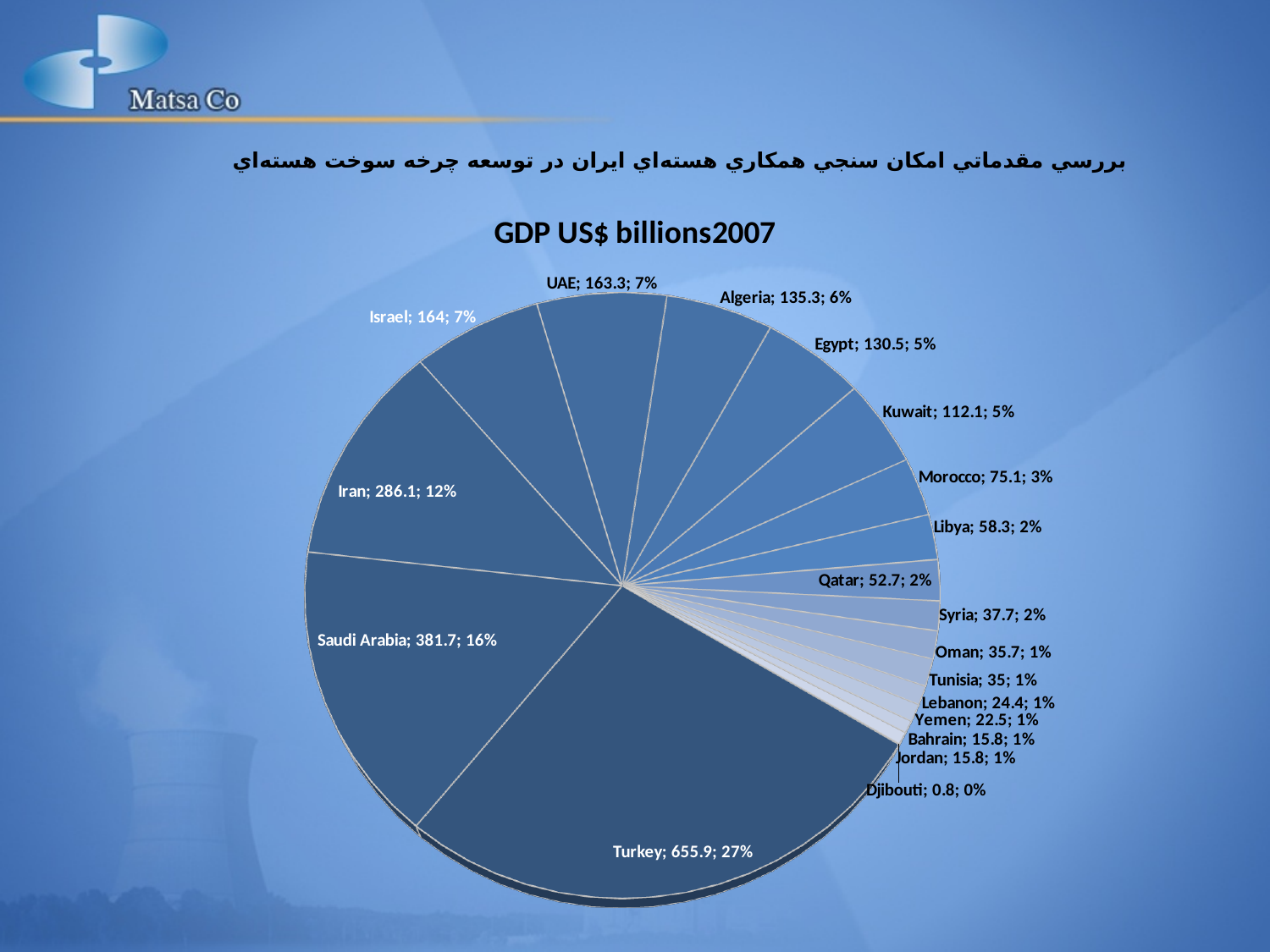
What type of chart is shown on the slide? pie chart What is the GDP value shown for Iran? 286.1 Which country has the smallest slice of the pie? Djibouti How many countries are shown in the pie chart? 19 What is the GDP value shown for Saudi Arabia? 381.7 What is the difference between the GDP values of Turkey and Saudi Arabia? 274.2 What share of the pie does Saudi Arabia represent? 16% What is the GDP value shown for Morocco? 75.1 What is the title of the chart? GDP US$ billions2007 Which country has the largest slice of the pie? Turkey Which has a larger GDP value, Egypt or Kuwait? Egypt What share of the pie does Turkey represent? 27%